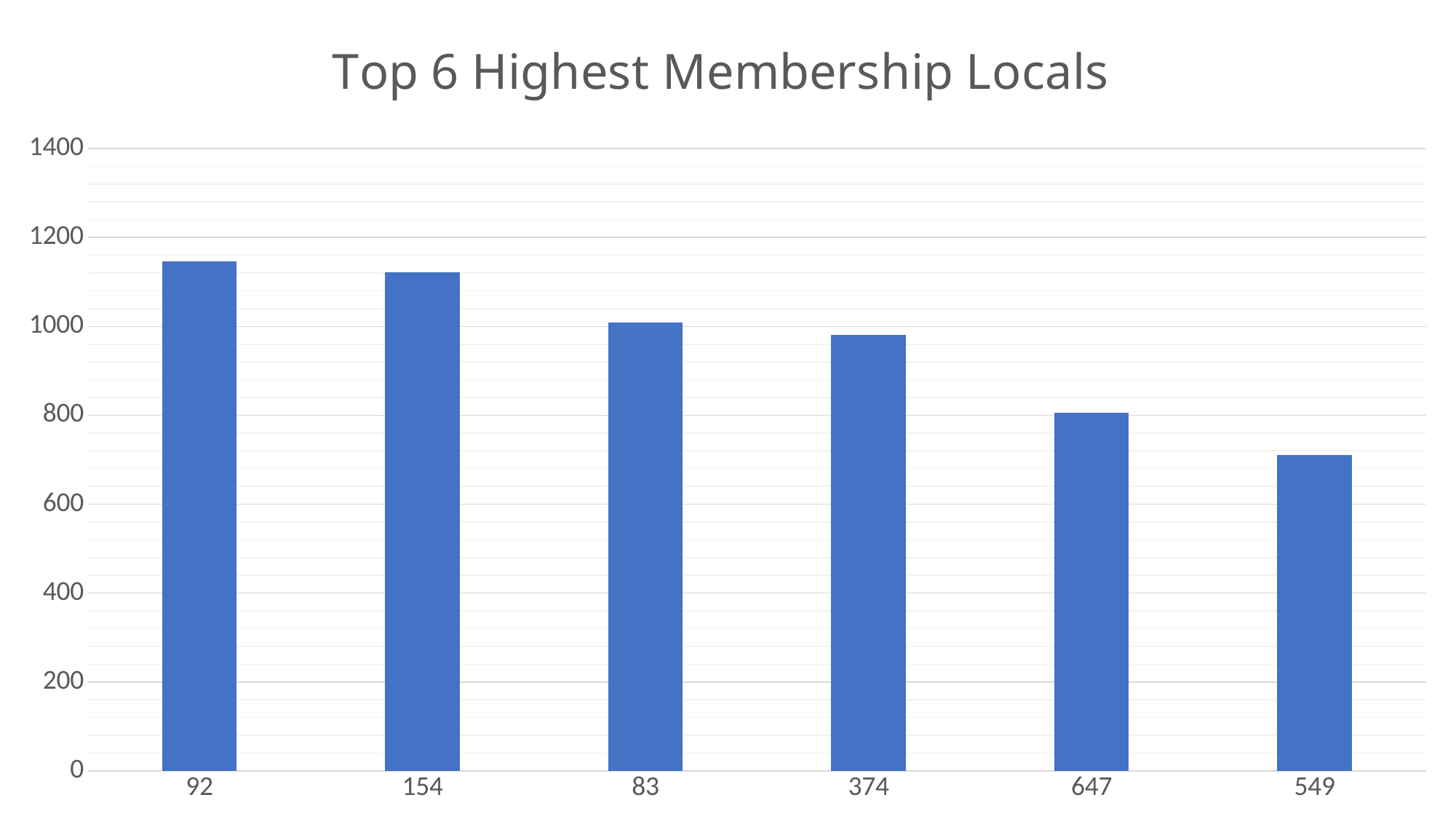
Is the membership value for local 374 greater or less than 800? greater What is the title of the chart? Top 6 Highest Membership Locals How many locals (bars) are shown in the chart? 6 Is the membership value for local 549 greater or less than 800? less Which local has a larger membership, 83 or 647? 83 Which local has the highest membership in the chart? 92 What kind of chart is shown on the slide? bar chart Is the membership value for local 647 greater or less than 600? greater Which local has the lowest membership in the chart? 549 Do the membership values rise or fall moving from left to right along the x axis? fall Which local has a larger membership, 549 or 154? 154